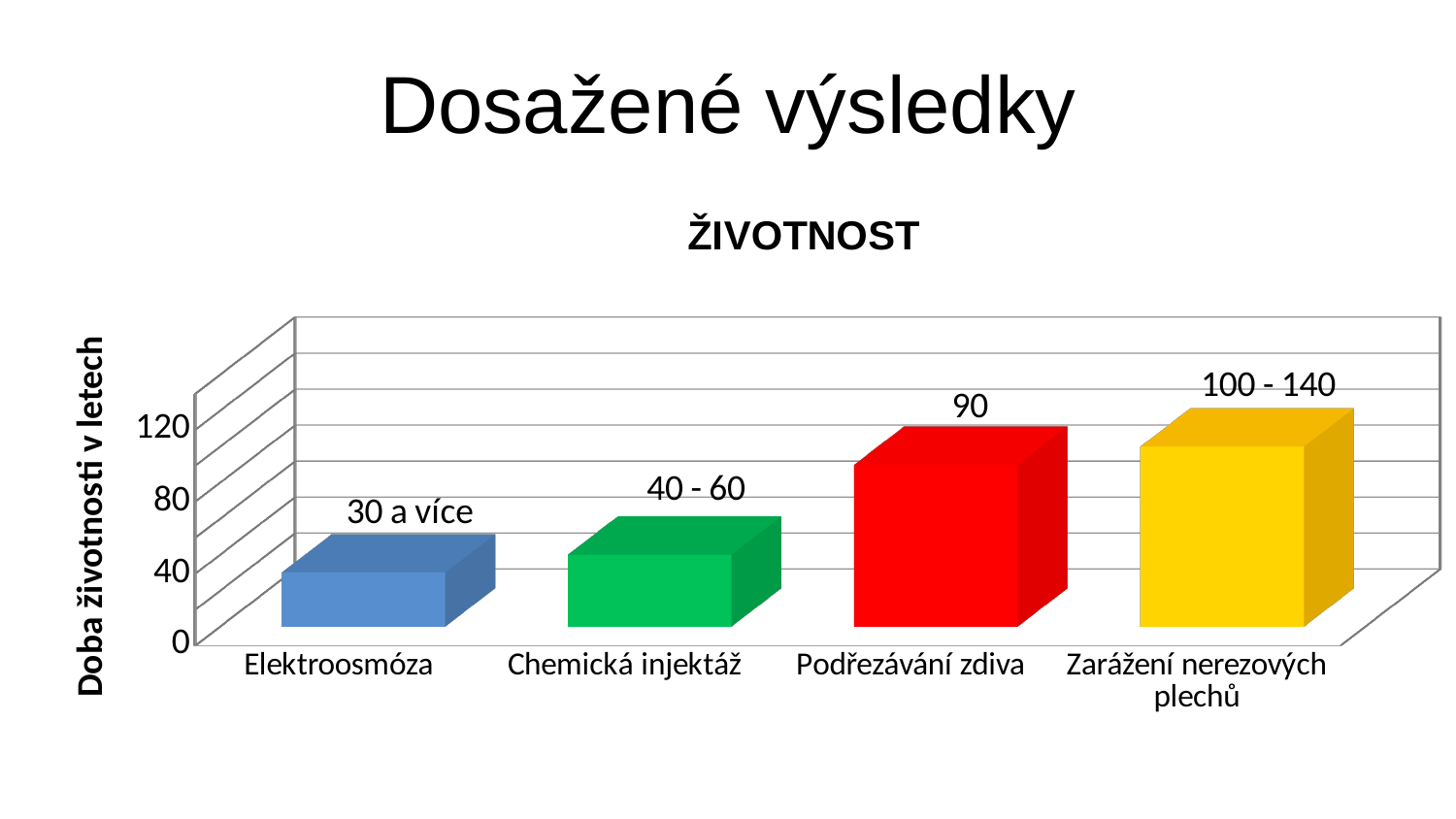
Which category has the lowest bar? Elektroosmóza How many categories are shown on the x axis? 4 What is the title of the chart? ŽIVOTNOST Which category has the highest bar? Zarážení nerezových plechů What kind of chart is shown on the slide? bar chart What is the data label shown for Zarážení nerezových plechů? 100 - 140 What is the value shown for Podřezávání zdiva? 90 Is the value for Podřezávání zdiva greater or less than 80? greater What is the data label shown for Elektroosmóza? 30 a více What is the data label shown for Chemická injektáž? 40 - 60 Which has a higher bar, Podřezávání zdiva or Chemická injektáž? Podřezávání zdiva Do the bars rise or fall from left to right along the x axis? rise